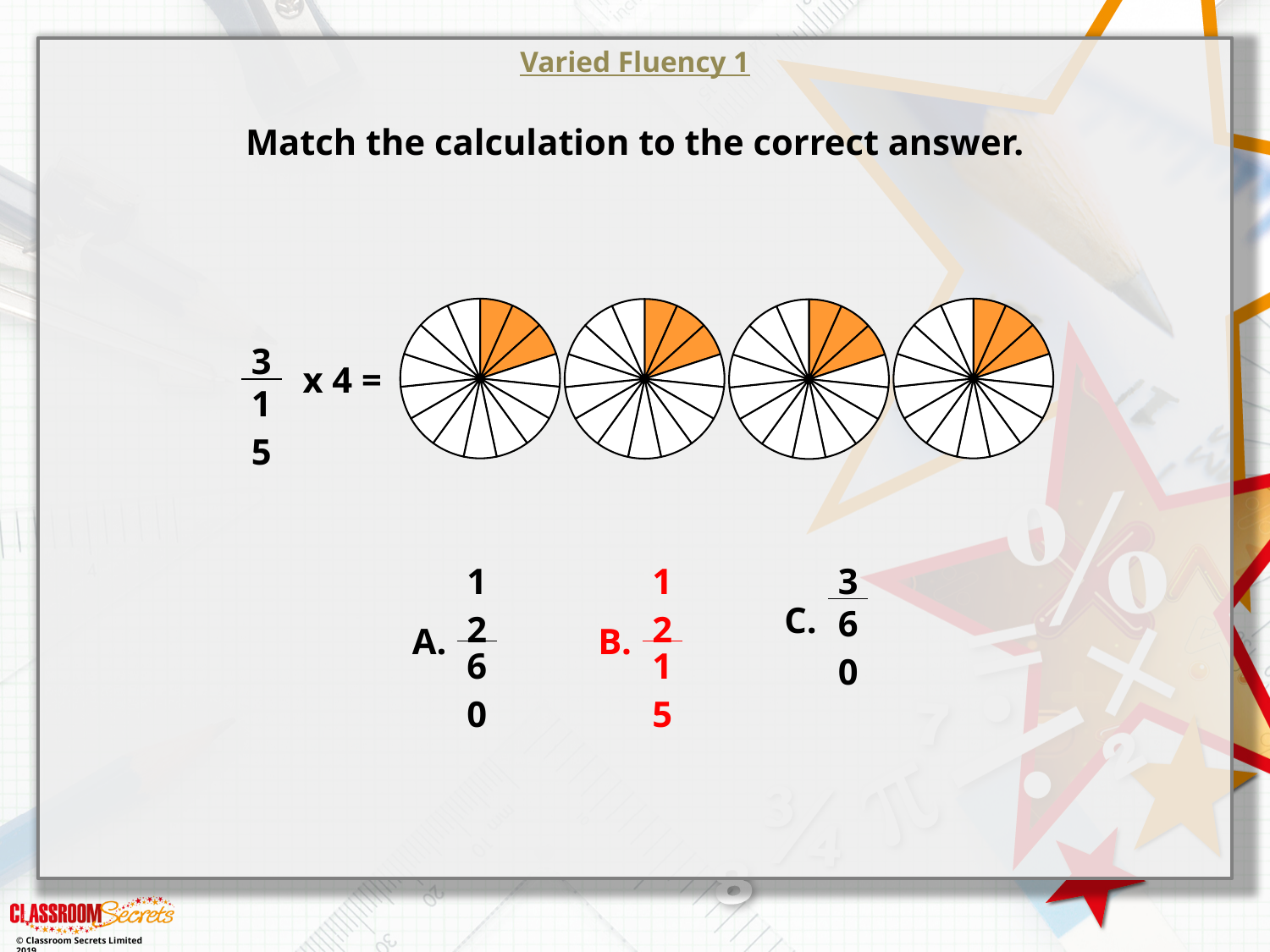
How many equal sections is each circle diagram divided into? 15 What colour are the shaded sections in the circle diagrams? Orange What fraction of each circle diagram is shaded orange? 3/15 How many sections are shaded orange in each circle diagram? 3 How many circle diagrams are shown next to the calculation on the slide? 4 Which answer option on the slide is highlighted in red? B